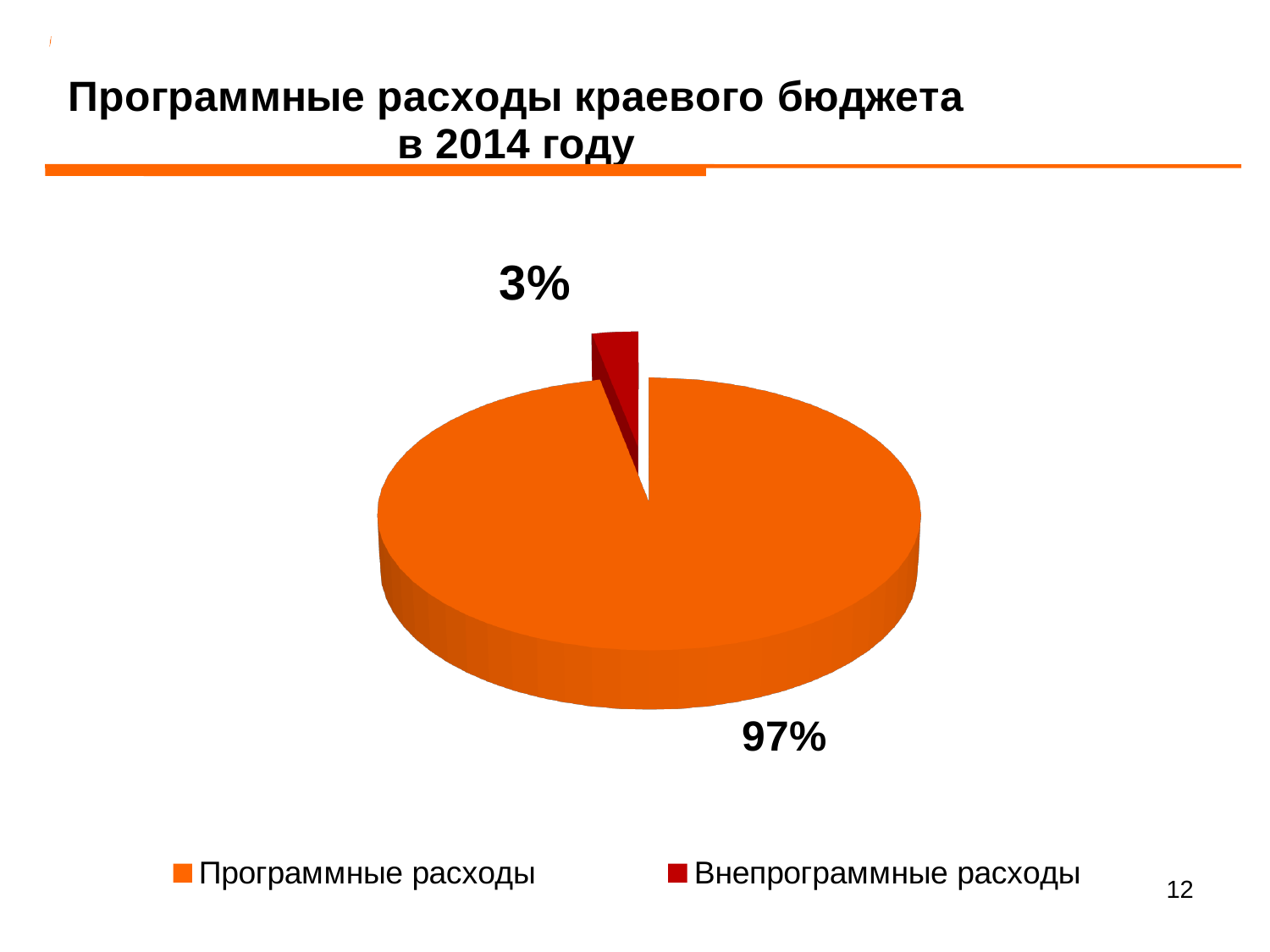
Which category has the largest slice of the pie? Программные расходы Which is larger, Программные расходы or Внепрограммные расходы? Программные расходы How many slices does the pie chart have? 2 Which category has the smallest slice of the pie? Внепрограммные расходы What kind of chart is shown on the slide? pie chart What is the title of the slide? Программные расходы краевого бюджета в 2014 году What is the difference in percentage points between Программные расходы and Внепрограммные расходы? 94 What colour is the slice for Внепрограммные расходы? red How many entries does the legend list? 2 What share of the pie does Программные расходы take? 97% What share of the pie does Внепрограммные расходы take? 3%